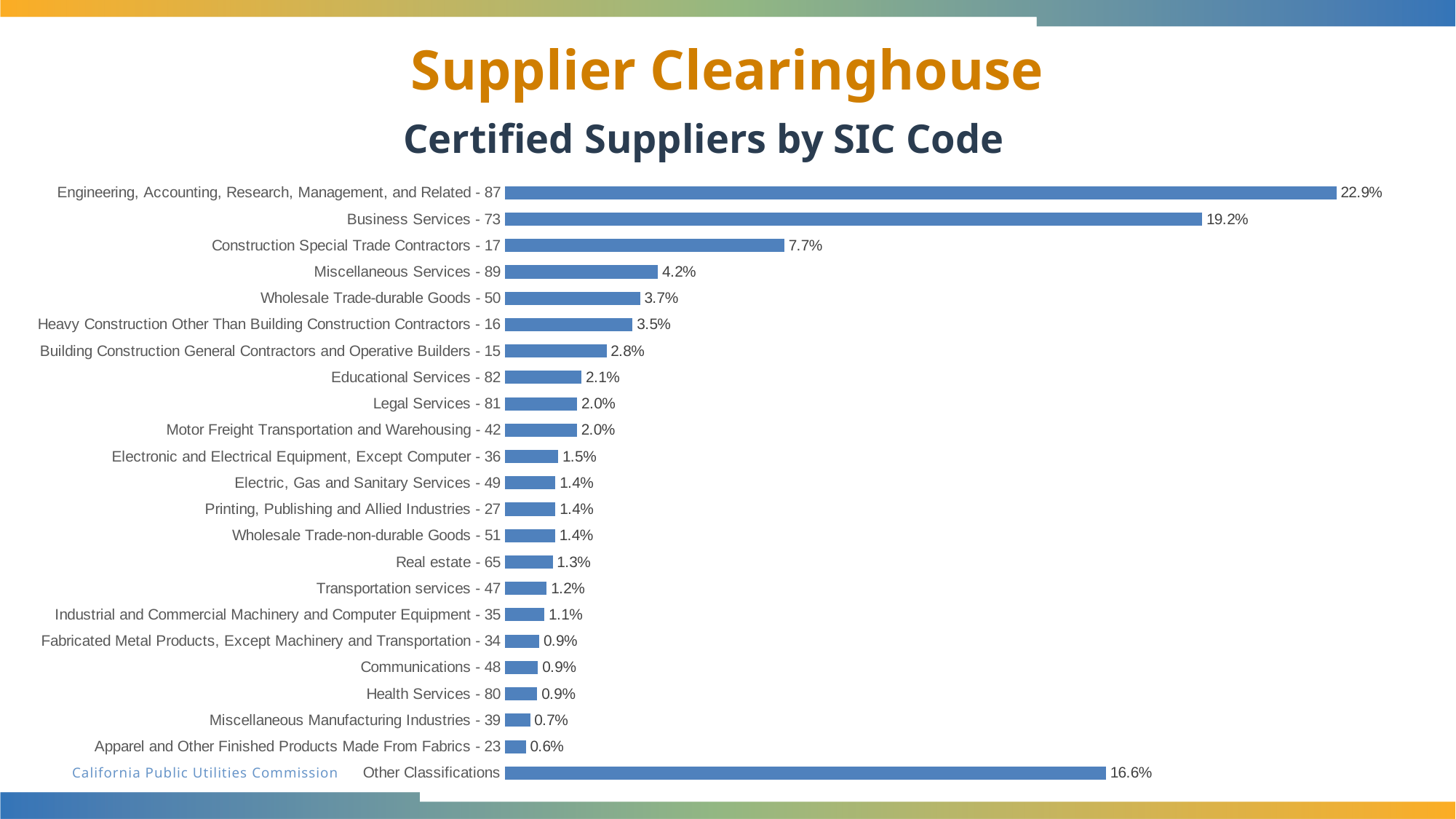
What percentage is shown for Construction Special Trade Contractors - 17? 7.7% What type of chart is shown on the slide? Bar chart What percentage is shown for Other Classifications? 16.6% Which has a larger percentage, Educational Services - 82 or Transportation services - 47? Educational Services - 82 Which category has the highest percentage? Engineering, Accounting, Research, Management, and Related - 87 What is the subtitle of the chart on the slide? Certified Suppliers by SIC Code Which category has the lowest percentage? Apparel and Other Finished Products Made From Fabrics - 23 What percentage is shown for Business Services - 73? 19.2% What is the difference in percentage points between Miscellaneous Services - 89 and Wholesale Trade-durable Goods - 50? 0.5 What is the difference in percentage points between Engineering, Accounting, Research, Management, and Related - 87 and Business Services - 73? 3.7 How many categories (bars) are shown in the chart? 23 What percentage is shown for Real estate - 65? 1.3%